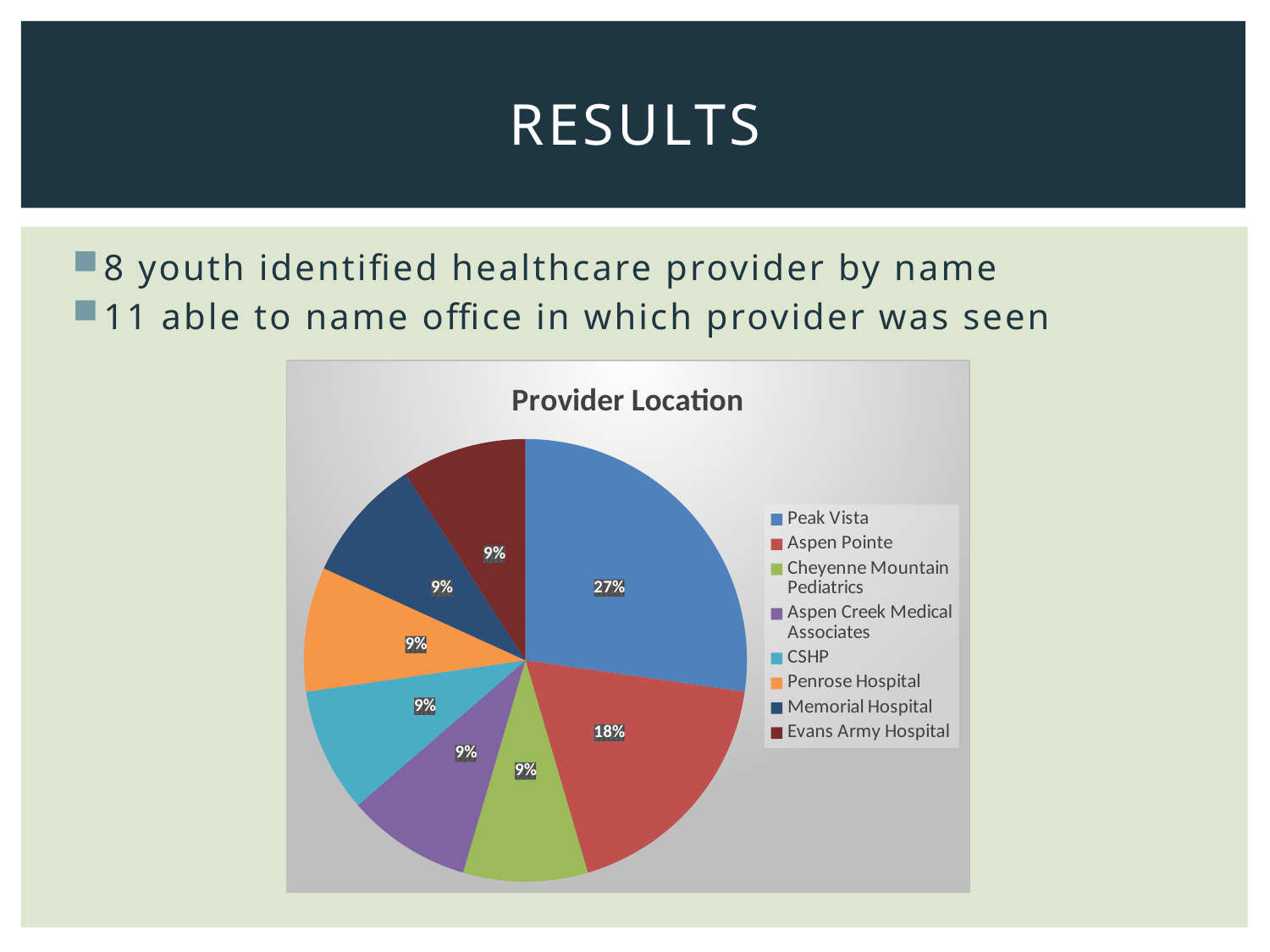
Which is larger, the share for Aspen Pointe or the share for CSHP? Aspen Pointe What is the difference between the Peak Vista share and the Aspen Pointe share? 9% Is the share for Peak Vista greater or less than 25%? greater What is the title of the chart? Provider Location What share of the pie does Aspen Pointe represent? 18% Which provider location has the largest slice of the pie? Peak Vista What colour is the Peak Vista slice? blue How many slices are labelled 9%? 6 How many categories does the legend list? 8 What share of the pie does Peak Vista represent? 27% What share of the pie does Penrose Hospital represent? 9% What type of chart is shown on the slide? pie chart